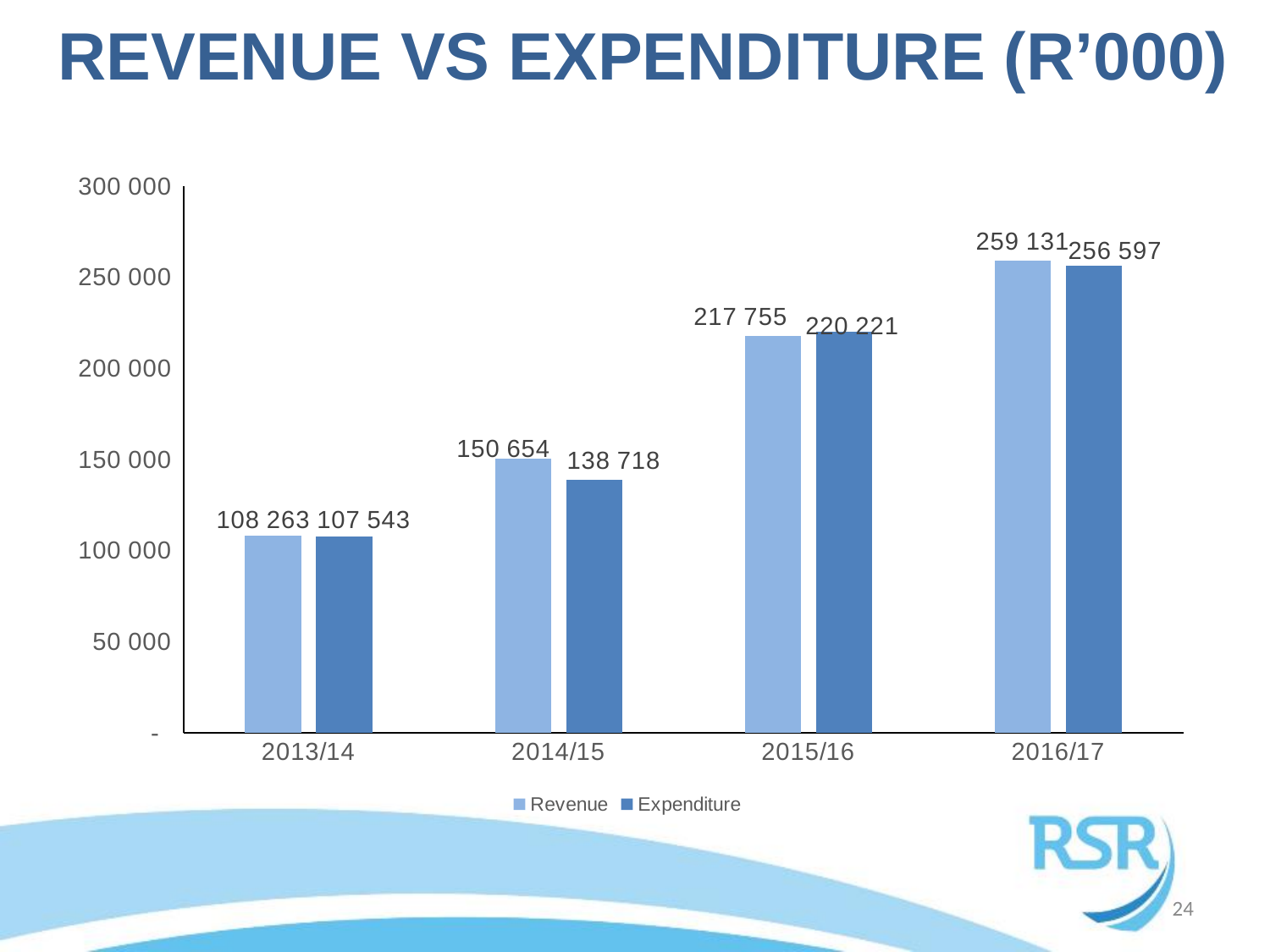
What is the Expenditure value for 2016/17? 256 597 What is the difference between Revenue and Expenditure in 2014/15? 11 936 In which year is Revenue highest? 2016/17 How many years are shown on the x axis? 4 Which is larger in 2014/15, Revenue or Expenditure? Revenue Is the Revenue value for 2015/16 greater or less than 200 000? greater What is the Revenue value for 2013/14? 108 263 How many series does the legend list? 2 What is the Revenue value for 2014/15? 150 654 In which year is Expenditure lowest? 2013/14 What is the Expenditure value for 2015/16? 220 221 Does Revenue rise or fall from 2013/14 to 2016/17? rise